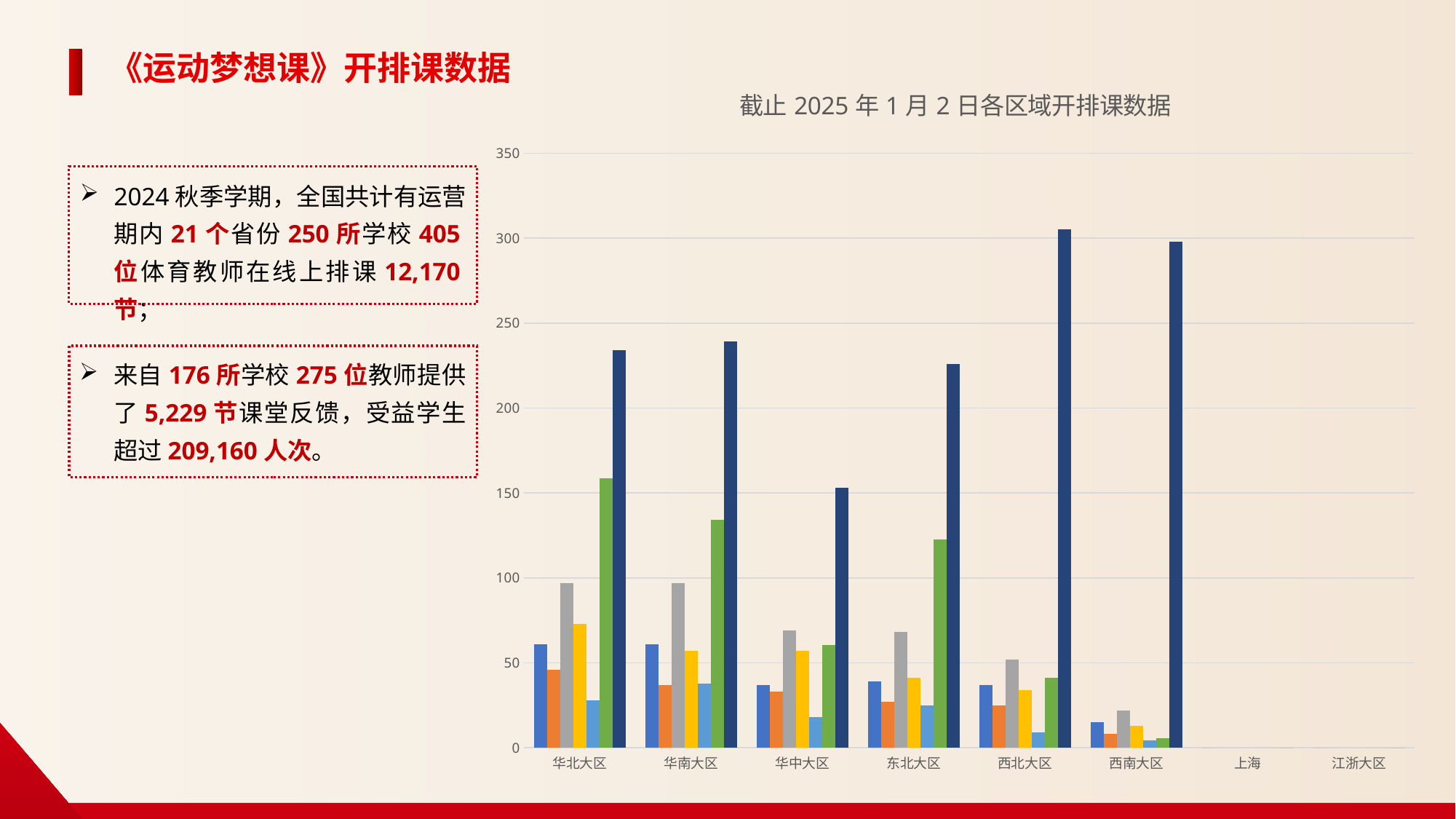
Which category has the taller green bar: 华北大区 or 华南大区? 华北大区 Is the tallest bar for 西北大区 greater or less than 250? greater Is the tallest bar for 华北大区 greater or less than 200? greater Is the tallest bar for 华中大区 greater or less than 200? less Which category has the tallest bar: 华南大区 or 华中大区? 华南大区 What is the title of the chart? 截止 2025 年 1 月 2 日各区域开排课数据 What kind of chart is shown on the slide? bar chart What is the highest value shown on the chart's vertical axis? 350 Which category on the x axis has no visible bars at all? 上海 and 江浙大区 How many categories are shown on the x axis of the chart? 8 Among the categories with visible bars, which has the lowest tallest bar? 华中大区